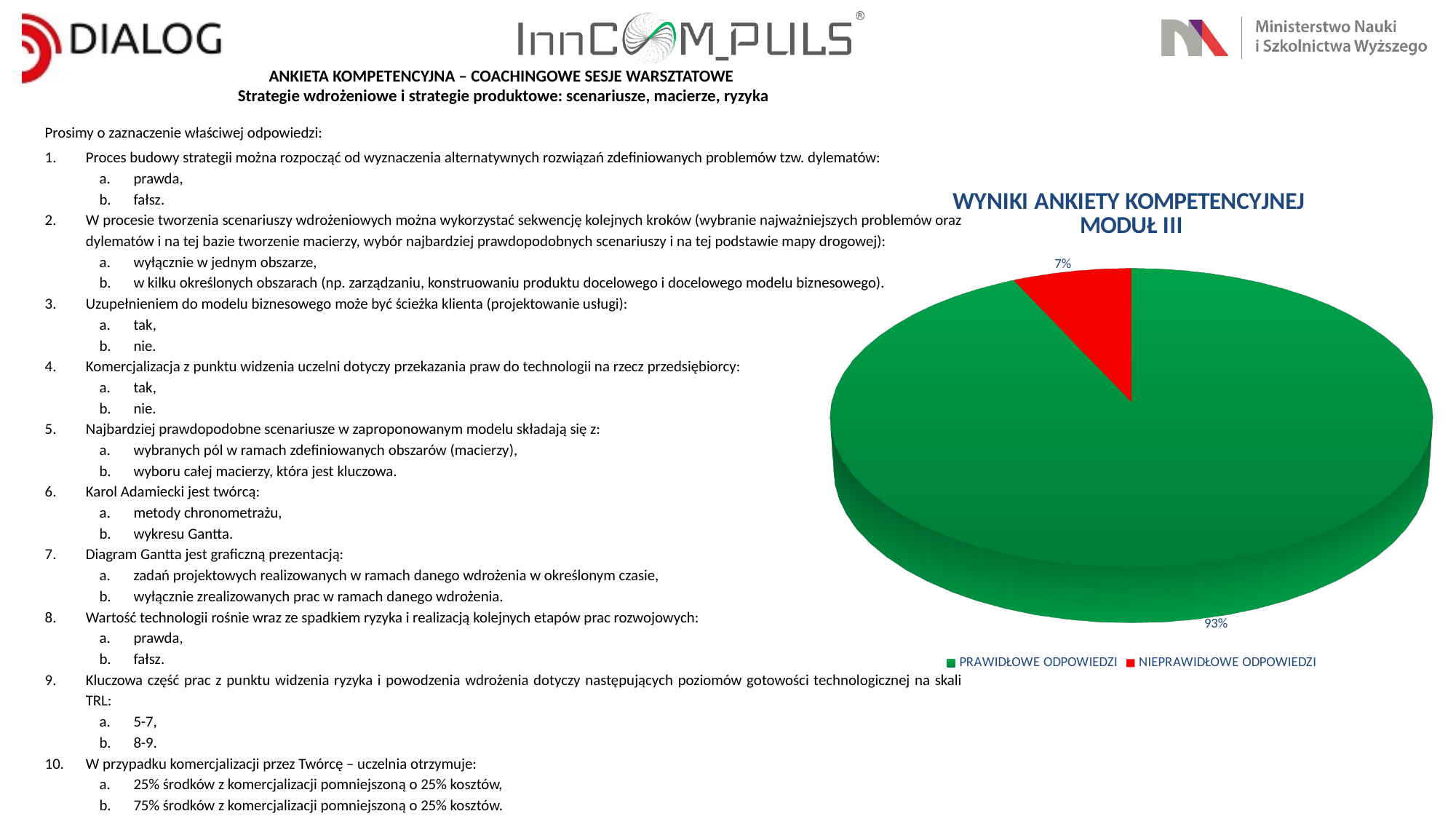
How many slices does the pie chart have? 2 What colour is the NIEPRAWIDŁOWE ODPOWIEDZI slice in the pie chart? Red What share of the pie chart is labelled NIEPRAWIDŁOWE ODPOWIEDZI? 7% What share of the pie chart is labelled PRAWIDŁOWE ODPOWIEDZI? 93% How many entries does the chart legend list? 2 What is the difference in percentage points between the PRAWIDŁOWE ODPOWIEDZI and NIEPRAWIDŁOWE ODPOWIEDZI slices? 86 percentage points Which slice of the pie chart is the smallest? NIEPRAWIDŁOWE ODPOWIEDZI Which slice of the pie chart is the largest? PRAWIDŁOWE ODPOWIEDZI What kind of chart is shown on the slide? Pie chart Which is larger in the pie chart: PRAWIDŁOWE ODPOWIEDZI or NIEPRAWIDŁOWE ODPOWIEDZI? PRAWIDŁOWE ODPOWIEDZI What is the title of the chart? WYNIKI ANKIETY KOMPETENCYJNEJ MODUŁ III